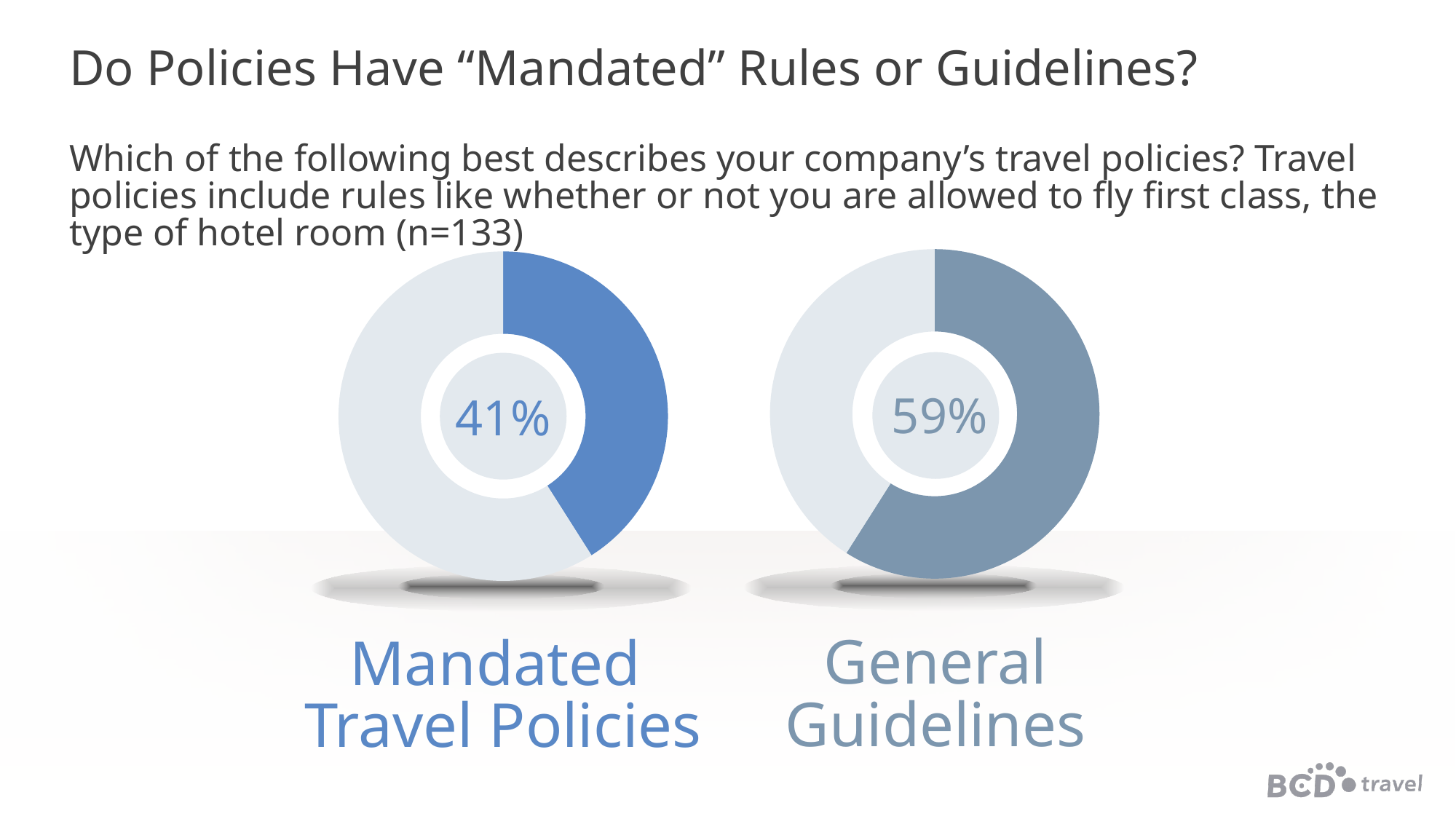
What percentage is shown in the General Guidelines donut chart? 59% What is the total of the two percentages shown on the slide? 100% What is the difference in percentage points between General Guidelines and Mandated Travel Policies? 18 What is the sample size (n) stated in the survey question on the slide? 133 How many donut charts are on the slide? 2 What percentage is shown in the Mandated Travel Policies donut chart? 41% Which option has the lowest percentage on the slide? Mandated Travel Policies Which option has the highest percentage on the slide? General Guidelines What kind of charts are shown on the slide? Donut (pie) charts What is the title of the slide? Do Policies Have "Mandated" Rules or Guidelines? Is the value for Mandated Travel Policies greater or less than 50%? less Which of the two donut charts shows the higher percentage, Mandated Travel Policies or General Guidelines? General Guidelines